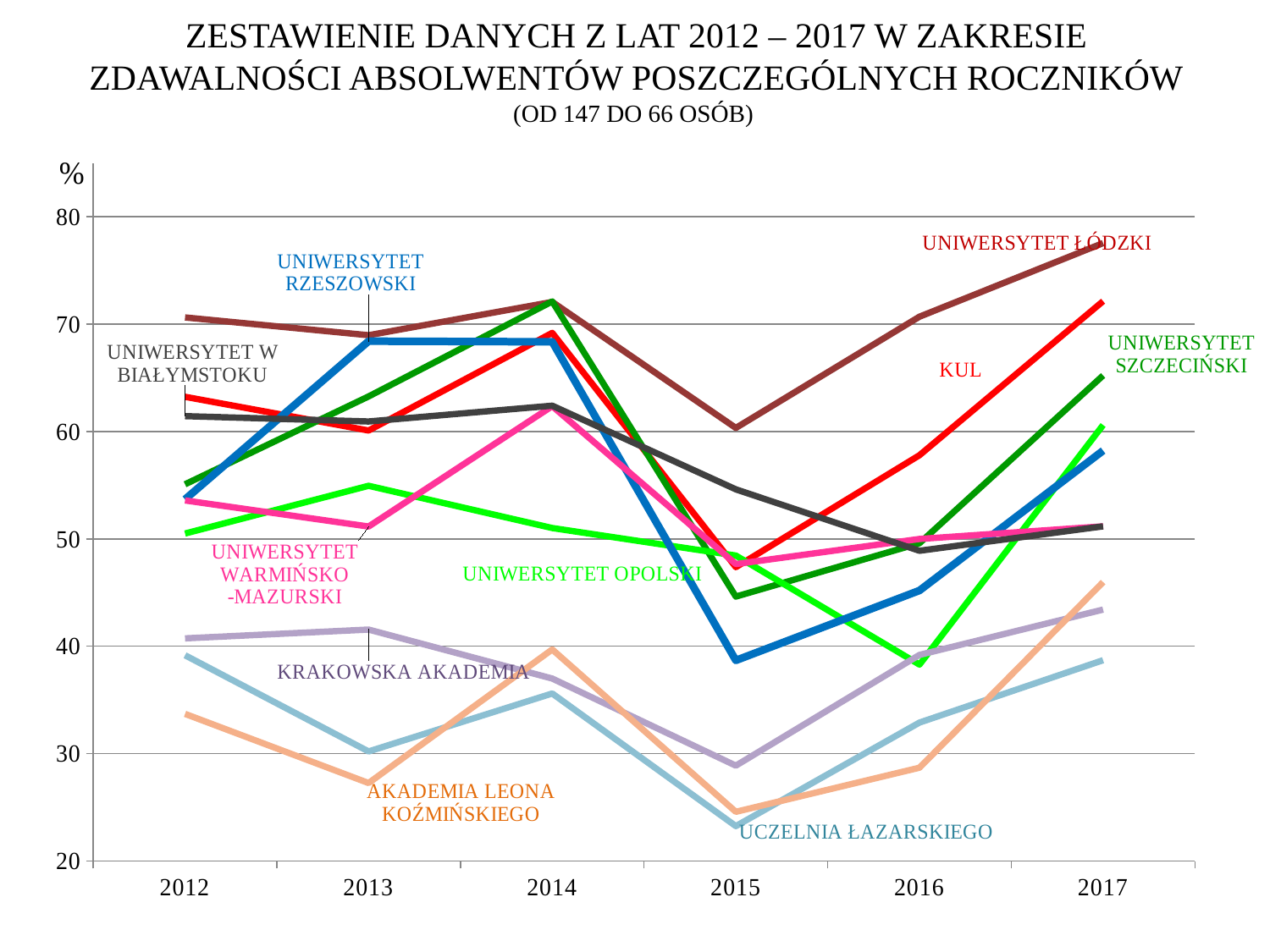
Which university has the highest value in 2017? Uniwersytet Łódzki Is the value for Uczelnia Łazarskiego in 2015 greater or less than 30? less How many years are plotted along the x axis? 6 Which university has the highest value in 2015? Uniwersytet Łódzki What unit is shown on the y axis of the chart? % In 2016, which is larger: the value for Uniwersytet Łódzki or for KUL? Uniwersytet Łódzki Is the value for Uniwersytet Rzeszowski in 2015 greater or less than 50? less Is the value for Uniwersytet Szczeciński in 2015 greater or less than 50? less Which institution has the lowest value in 2012? Akademia Leona Koźmińskiego What kind of chart is shown on the slide? line chart Does the value for Uniwersytet Łódzki rise or fall from 2015 to 2017? rise